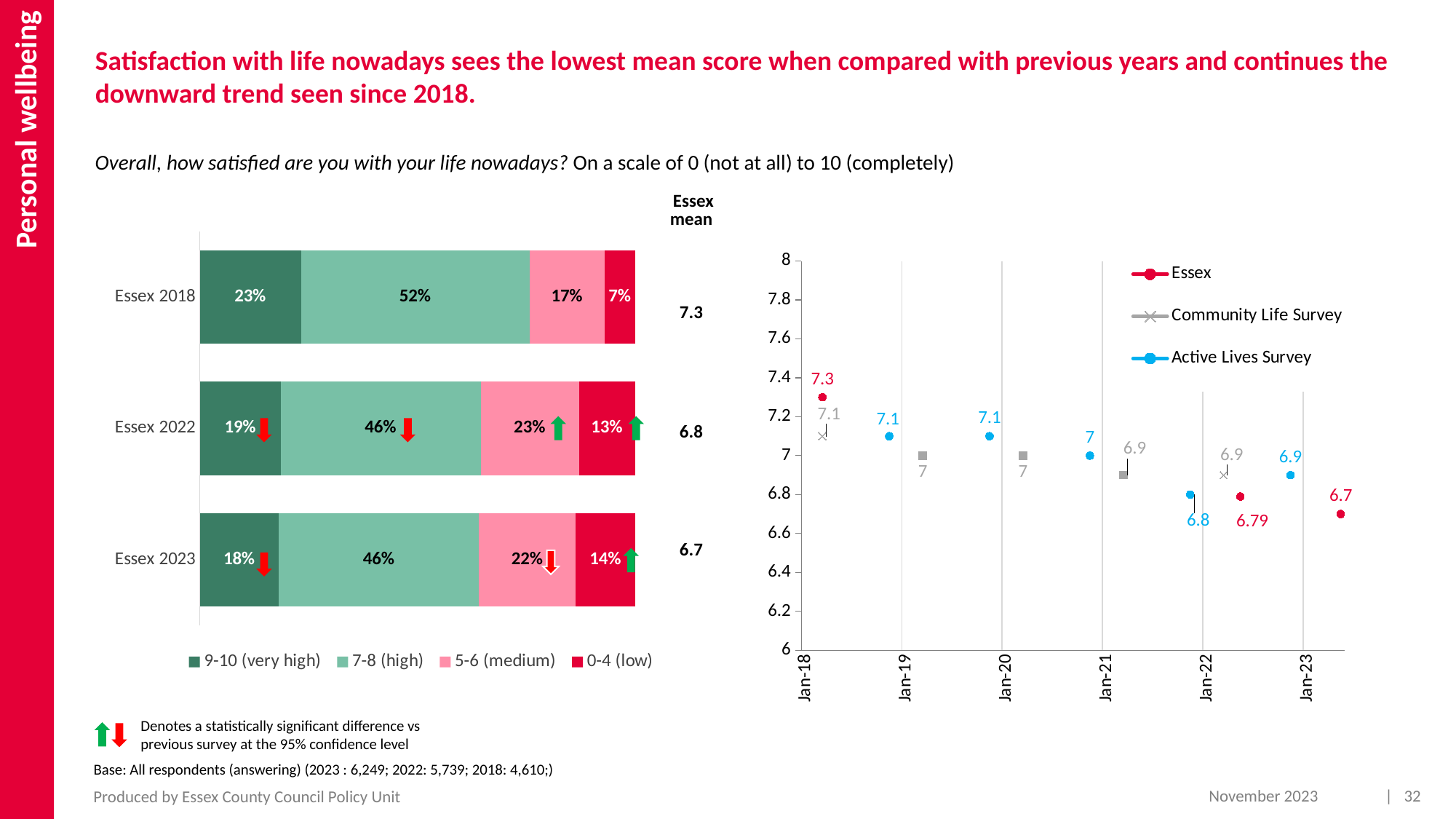
In the chart on the right, what is the latest Essex value plotted, near Jan-23? 6.7 In the stacked bar chart on the left, how many series does the legend list? 4 In the stacked bar chart on the left, what is the difference in the 5-6 (medium) share between Essex 2022 and Essex 2018? 6% In the stacked bar chart on the left, what percentage of Essex 2023 respondents gave a 0-4 (low) score? 14% In the chart on the right, how many series does the legend list? 3 In the stacked bar chart on the left, what percentage of Essex 2018 respondents gave a 9-10 (very high) score? 23% In the stacked bar chart on the left, what is the Essex mean score shown for Essex 2022? 6.8 In the stacked bar chart on the left, which year has the highest share of 7-8 (high) responses? Essex 2018 In the chart on the right, which is larger: the Active Lives Survey value at Jan-19 or the Active Lives Survey value labelled 6.8 near Jan-22? Jan-19 (7.1) In the chart on the right, what is the Essex value plotted at Jan-18? 7.3 In the stacked bar chart on the left, how many bars (years) are shown? 3 In the chart on the right, do the Essex values rise or fall from Jan-18 to Jan-23? fall